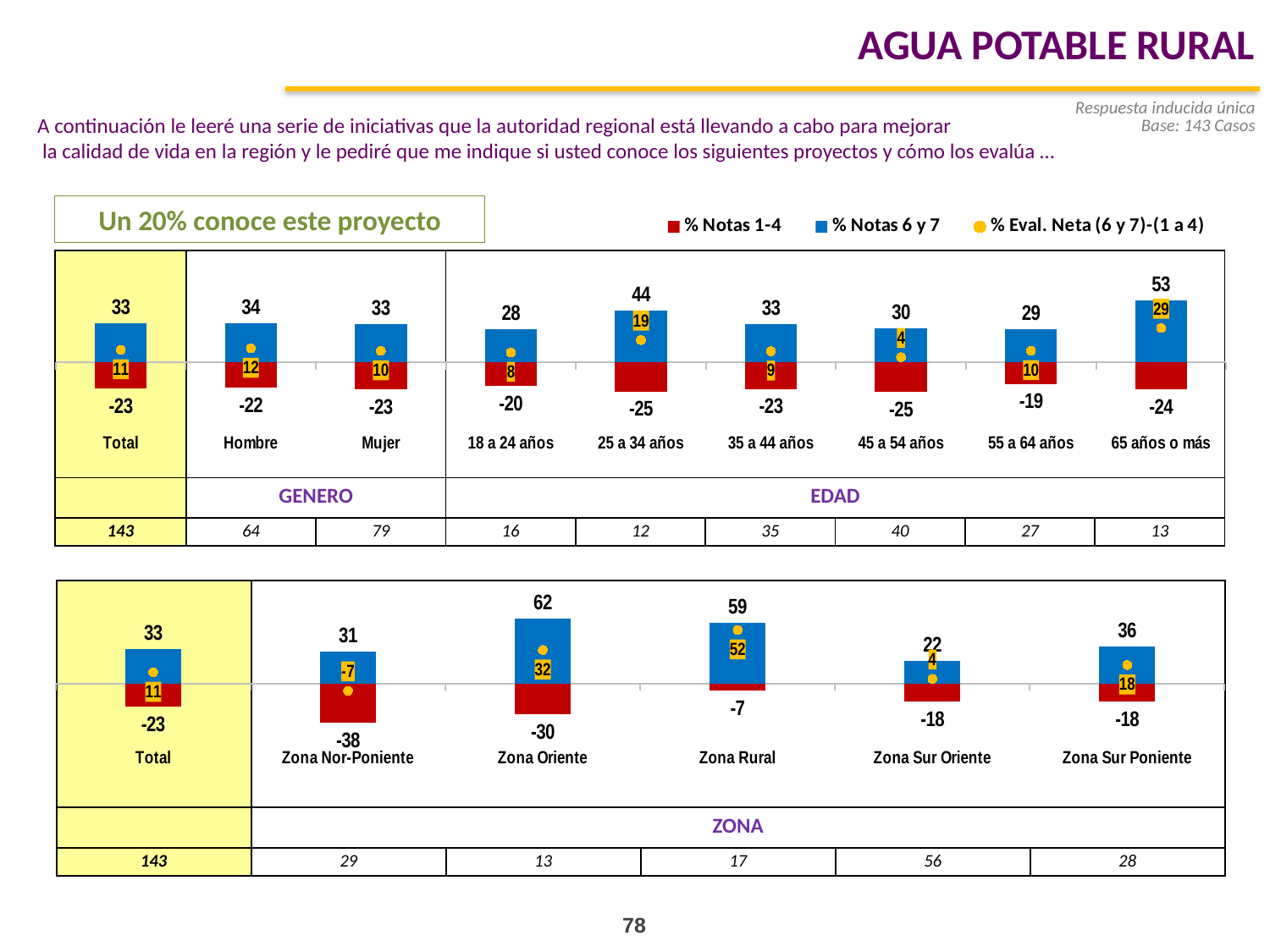
In the top chart, what is the difference between the % Notas 6 y 7 values for Hombre and Mujer? 1 In the top chart, which age group has the highest % Notas 6 y 7 value? 65 años o más In the bottom chart, which zone has the highest % Eval. Neta value? Zona Rural How many series does the legend list? 3 In the top chart, what is the % Eval. Neta value for 65 años o más? 29 In the top chart, what is the % Notas 1-4 value for 55 a 64 años? -19 In the top chart, which age group has the lowest % Eval. Neta value? 45 a 54 años In the top chart, what is the % Notas 6 y 7 value for 25 a 34 años? 44 In the bottom chart, what is the % Notas 6 y 7 value for Zona Oriente? 62 In the bottom chart, what is the % Notas 1-4 value for Zona Nor-Poniente? -38 What kind of chart is the bottom chart? Combination bar and line chart (stacked bars with dot markers for the net evaluation) In the bottom chart, is the % Notas 6 y 7 value larger for Zona Rural or Zona Sur Poniente? Zona Rural